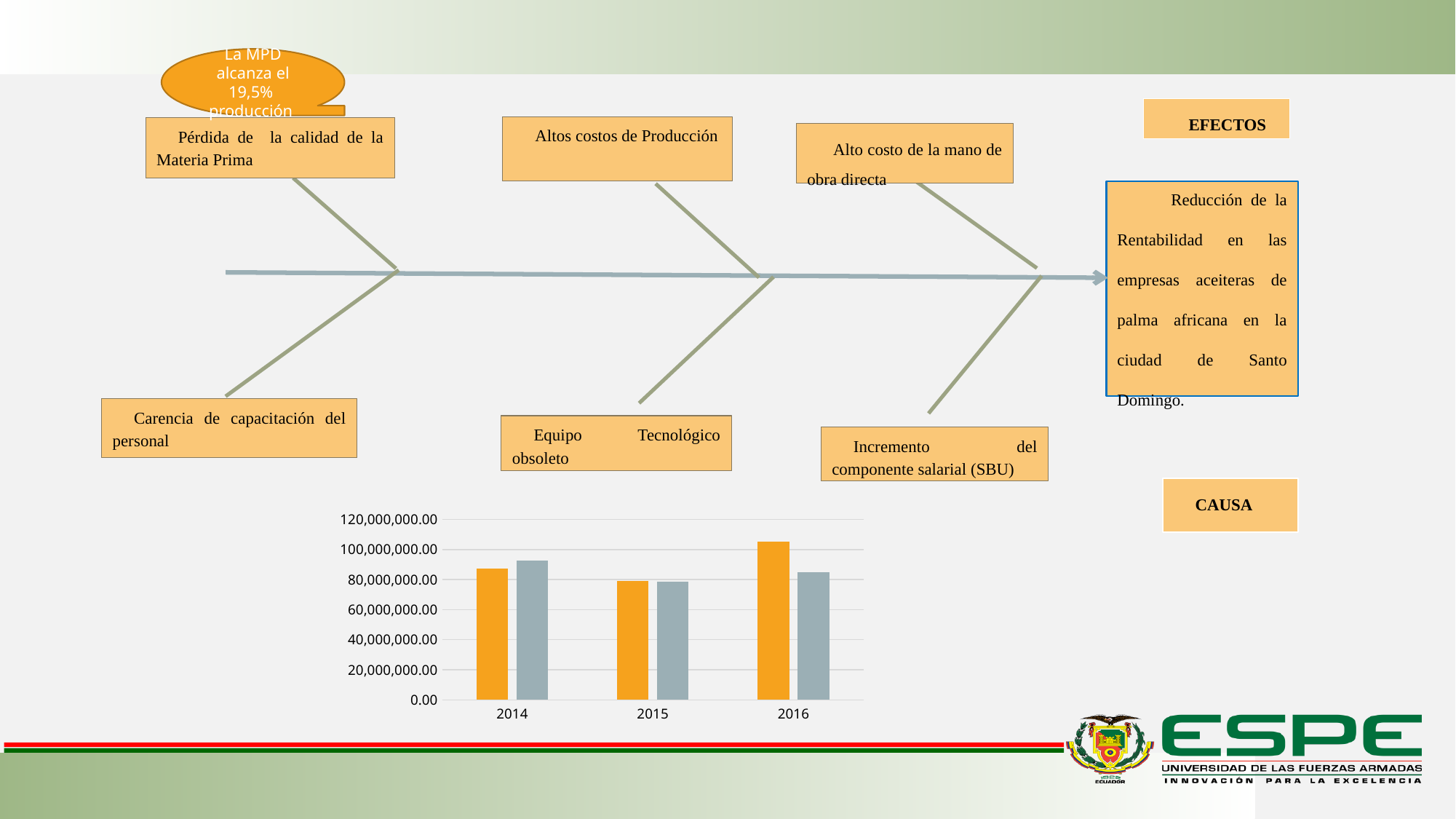
In the bar chart, which year has the shortest orange bar? 2015 In the bar chart, which year has the tallest orange bar? 2016 In the bar chart, which year has the tallest bar overall? 2016 What is the highest value shown on the y axis of the bar chart? 120,000,000.00 In the bar chart, is the orange bar for 2016 greater or less than 100,000,000.00? greater What kind of chart is shown at the bottom of the slide? bar chart How many bars are plotted for each year in the bar chart? 2 In the bar chart, is the gray bar for 2016 greater or less than 80,000,000.00? greater How many years are shown on the x axis of the bar chart? 3 In the bar chart, is the gray bar for 2014 greater or less than 100,000,000.00? less In the bar chart, for 2016, which bar is taller, the orange one or the gray one? orange